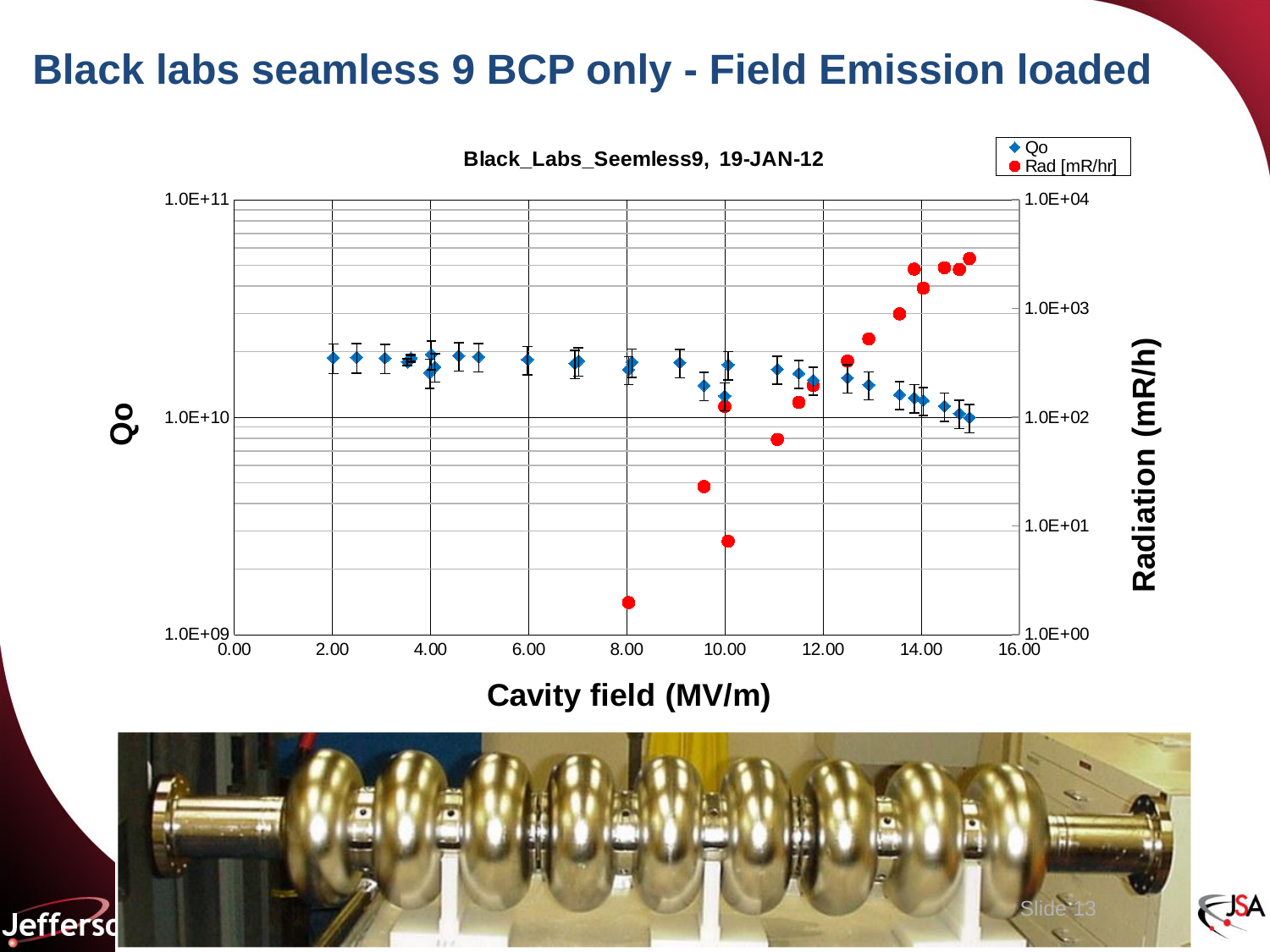
Which is larger: the radiation value at 14.00 MV/m or at 8.00 MV/m? 14.00 MV/m Is the Qo value at a cavity field of 2.00 MV/m greater or less than 1.0E+10? greater Which is larger: the Qo value at 2.00 MV/m or at 15.00 MV/m? 2.00 MV/m What is the label of the x axis of the chart? Cavity field (MV/m) What kind of chart is shown on the slide? Scatter chart How many series does the chart legend list? 2 Is the radiation value at a cavity field of 8.00 MV/m greater or less than 1.0E+01 mR/h? less Does the radiation (Rad [mR/hr]) series rise or fall as the cavity field increases from 8.00 to 15.00 MV/m? rise What is the title of the chart? Black_Labs_Seemless9, 19-JAN-12 Is the radiation value at a cavity field of 12.00 MV/m greater or less than 1.0E+02 mR/h? greater Does the Qo series rise or fall as the cavity field increases from 12.00 to 15.00 MV/m? fall